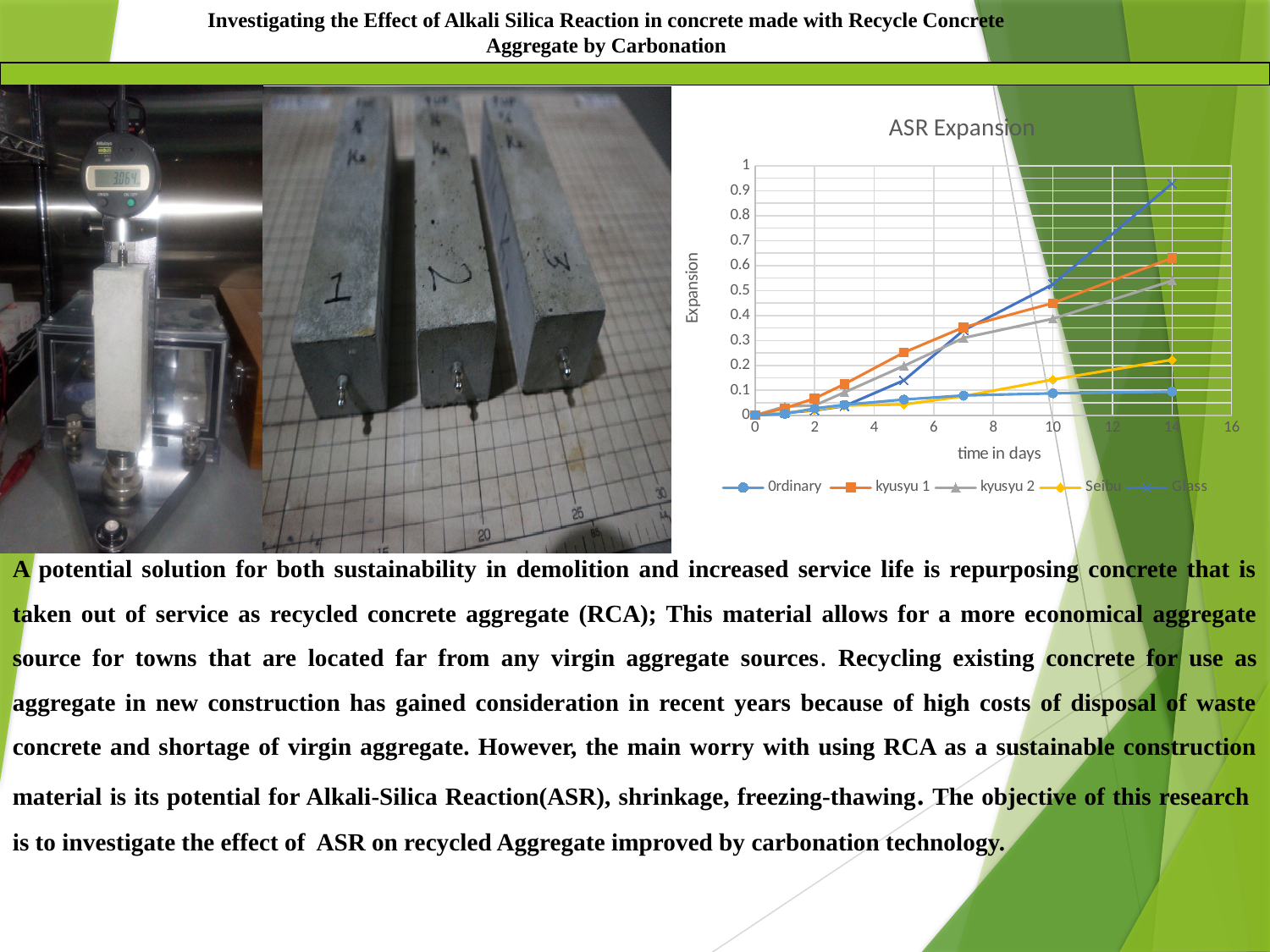
In the ASR Expansion chart, is the value for Seibu at day 14 greater or less than 0.3? less In the ASR Expansion chart, which series has the larger expansion at day 14, kyusyu 1 or kyusyu 2? kyusyu 1 In the ASR Expansion chart, which series has the lowest expansion at day 14? Ordinary In the ASR Expansion chart, is the value for Glass at day 14 greater or less than 0.8? greater In the ASR Expansion chart, is the value for Ordinary at day 14 greater or less than 0.2? less In the ASR Expansion chart, does the Glass series rise or fall as time in days increases? rise What kind of chart is the ASR Expansion chart? line chart How many series does the legend of the ASR Expansion chart list? 5 In the ASR Expansion chart, which series has the highest expansion at day 14? Glass What is the title of the chart on the slide? ASR Expansion What is the label of the x axis of the ASR Expansion chart? time in days